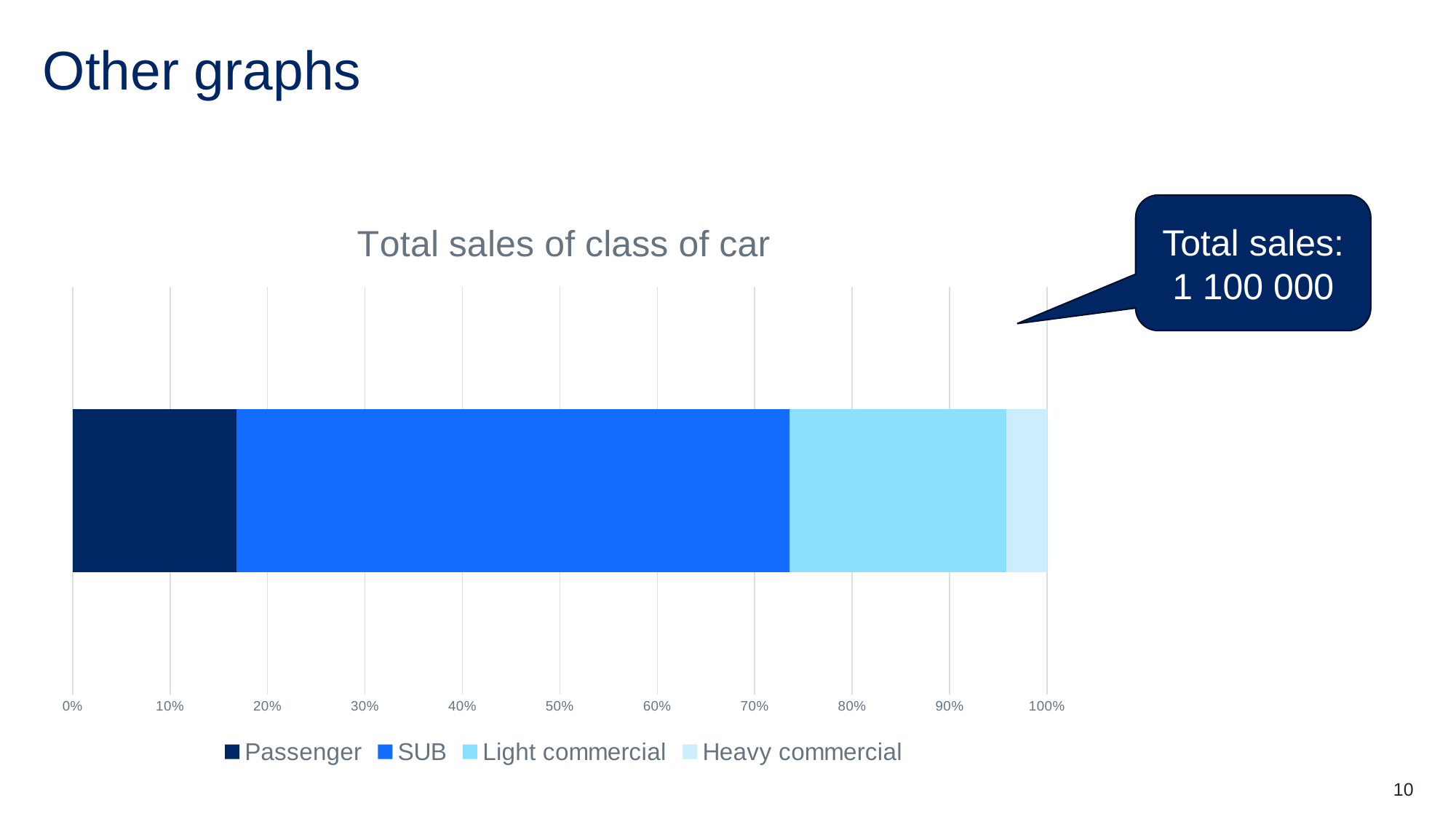
Is the share for Heavy commercial greater or less than 10%? less Which is larger, the share for SUB or the share for Passenger? SUB Which class of car has the smallest share of the bar? Heavy commercial Which is larger, the share for Light commercial or the share for Heavy commercial? Light commercial What kind of chart is shown on the slide? Stacked bar chart Is the share for Passenger greater or less than 20%? less Which class of car has the largest share of the bar? SUB How many series does the legend list? 4 What total sales figure is given in the callout next to the chart? 1 100 000 Is the share for SUB greater or less than 50%? greater What is the title of the chart? Total sales of class of car How many bars are plotted in the chart? 1